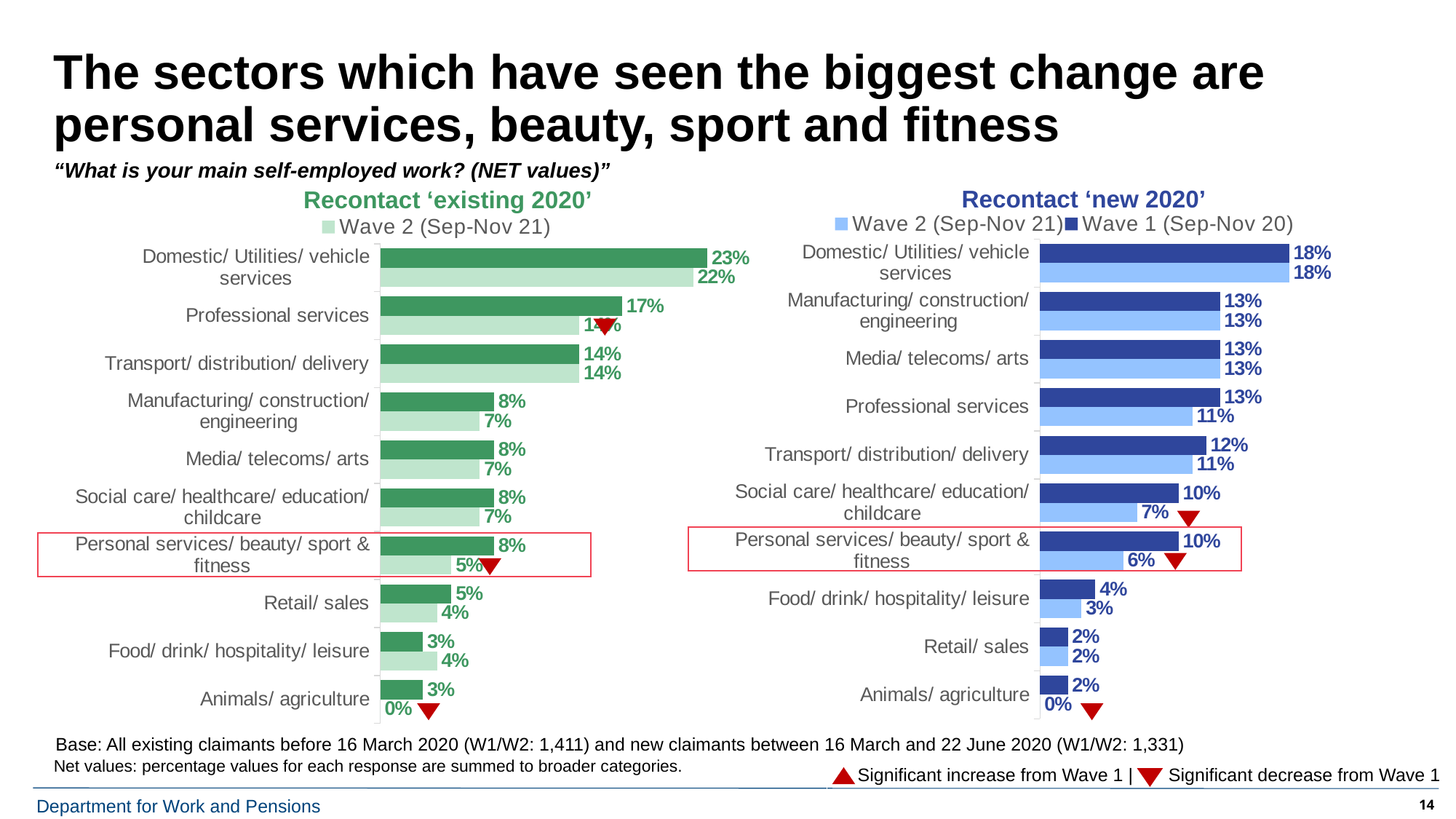
What type of chart is the 'Recontact ‘existing 2020’' chart? Bar chart In the 'Recontact ‘new 2020’' chart, which category has the highest Wave 1 (Sep-Nov 20) value? Domestic/ Utilities/ vehicle services In the 'Recontact ‘existing 2020’' chart, what is the Wave 2 (Sep-Nov 21) value for Animals/ agriculture? 0% In the 'Recontact ‘new 2020’' chart, what is the Wave 2 (Sep-Nov 21) value for Social care/ healthcare/ education/ childcare? 7% How many series does the legend of the 'Recontact ‘new 2020’' chart list? 2 In the 'Recontact ‘new 2020’' chart, which is larger for Wave 2 (Sep-Nov 21): Food/ drink/ hospitality/ leisure or Retail/ sales? Food/ drink/ hospitality/ leisure In the 'Recontact ‘new 2020’' chart, what is the difference between the Wave 1 and Wave 2 values for Personal services/ beauty/ sport & fitness? 4 percentage points Which category is highlighted with a red box in both charts? Personal services/ beauty/ sport & fitness How many categories are shown in the 'Recontact ‘new 2020’' chart? 10 In the 'Recontact ‘new 2020’' chart, what is the Wave 1 (Sep-Nov 20) value for Personal services/ beauty/ sport & fitness? 10% In the 'Recontact ‘existing 2020’' chart, what is the Wave 2 (Sep-Nov 21) value for Retail/ sales? 4% In the 'Recontact ‘existing 2020’' chart, what is the Wave 2 (Sep-Nov 21) value for Domestic/ Utilities/ vehicle services? 22%